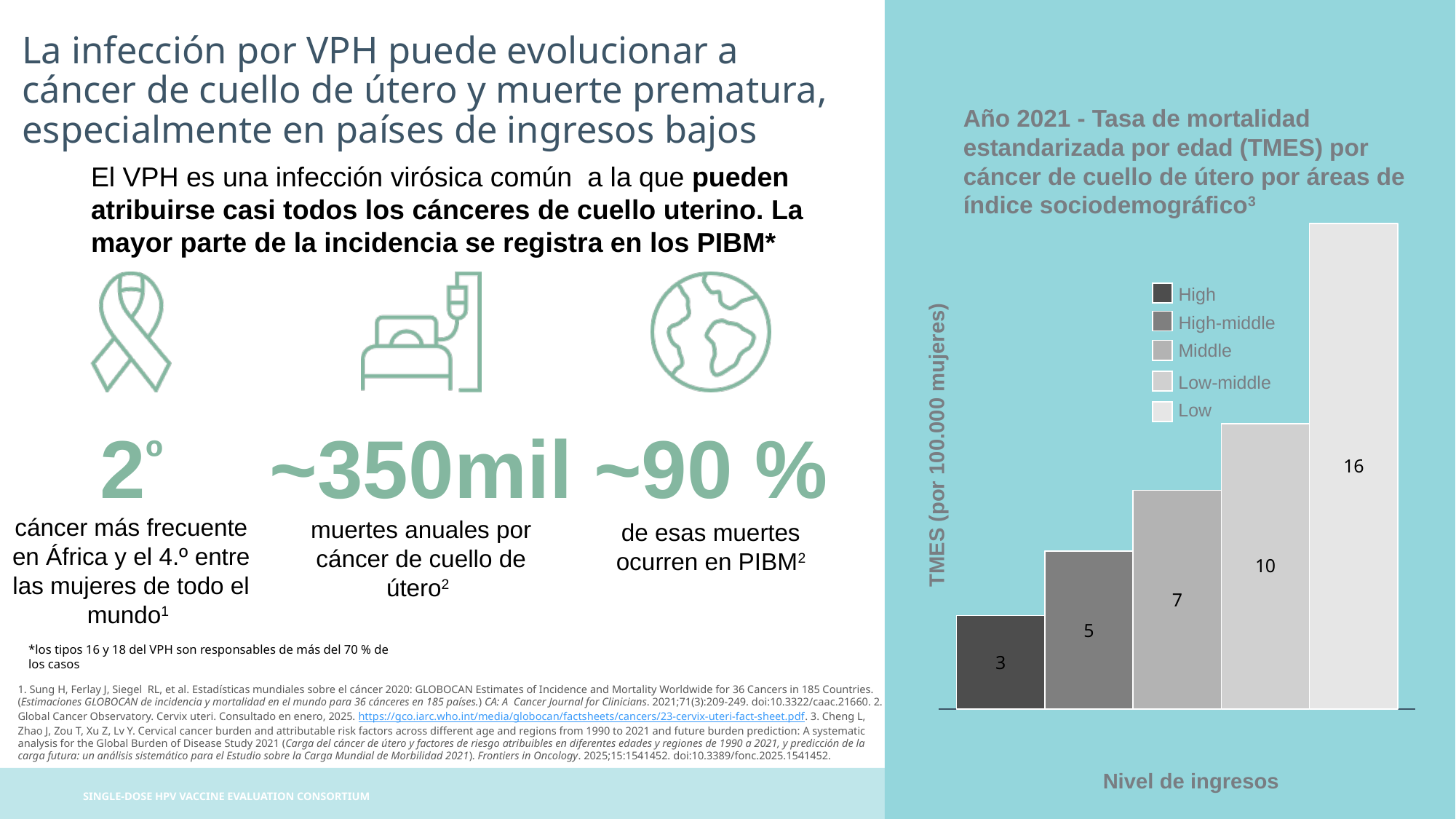
What is the difference in TMES between the Low-middle and Middle income levels? 3 Which has a higher TMES, Low-middle or High-middle? Low-middle What is the TMES value for the High-middle income level? 5 Which income level has the lowest TMES? High What kind of chart is shown on the slide? Bar chart How many entries does the chart legend list? 5 Which income level has the highest TMES? Low How many income levels are shown in the chart? 5 What is the TMES value for the Low income level? 16 What is the difference in TMES between the Low and High income levels? 13 What is the TMES value for the Middle income level? 7 Do the TMES values rise or fall moving from High to Low income level along the x axis? Rise